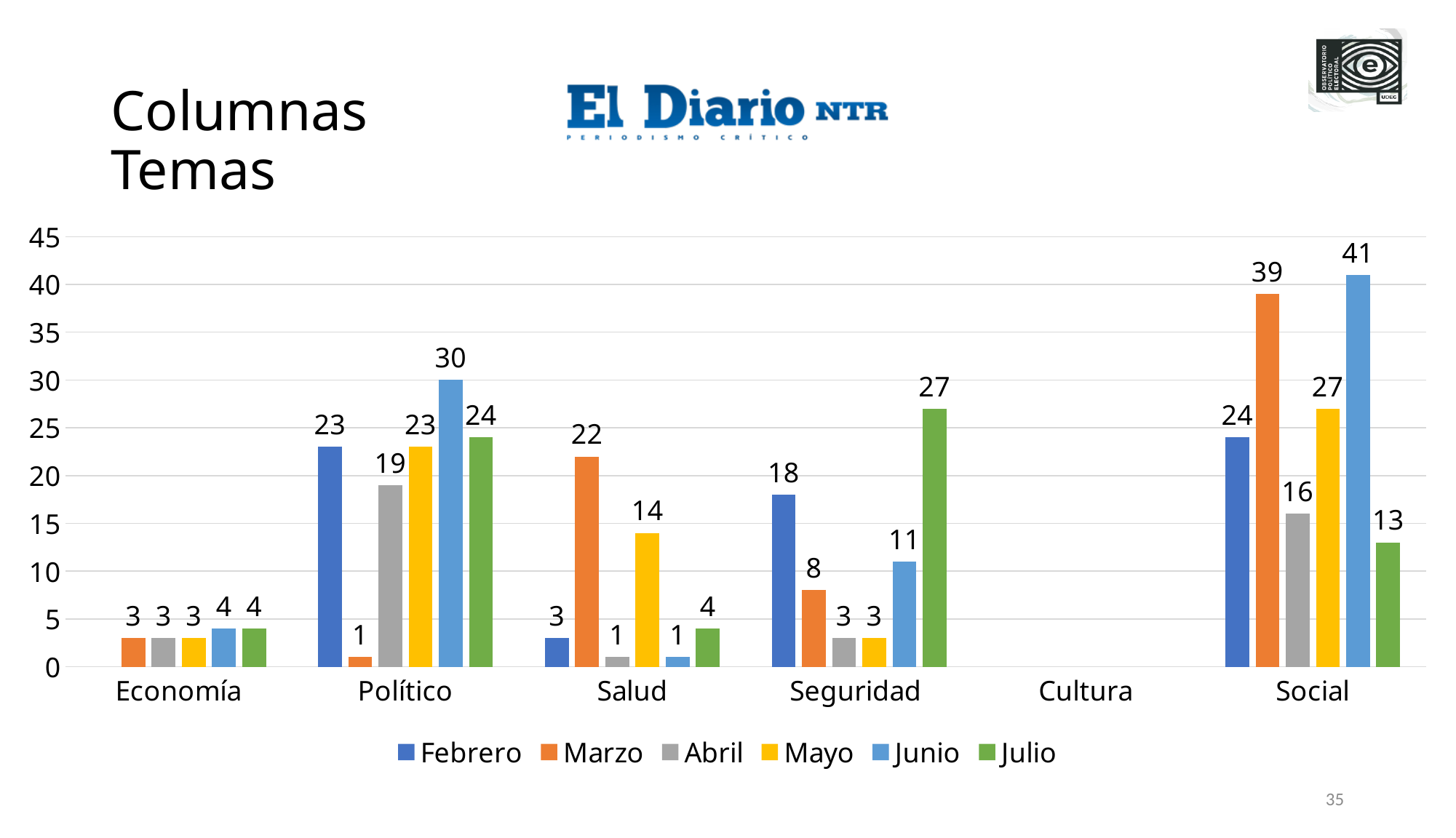
Which category on the x axis has no bars plotted? Cultura What is the value for Junio in the Político category? 30 What is the value for Mayo in the Salud category? 14 What kind of chart is shown on the slide? Bar chart What is the value for Julio in the Seguridad category? 27 How many categories are shown on the x axis? 6 What is the value for Marzo in the Social category? 39 What is the difference between the Junio and Julio values in the Social category? 28 Which month has the highest value in the Social category? Junio Which month has the lowest value in the Político category? Marzo How many series does the legend list? 6 Which is larger in the Seguridad category, the Febrero value or the Junio value? Febrero